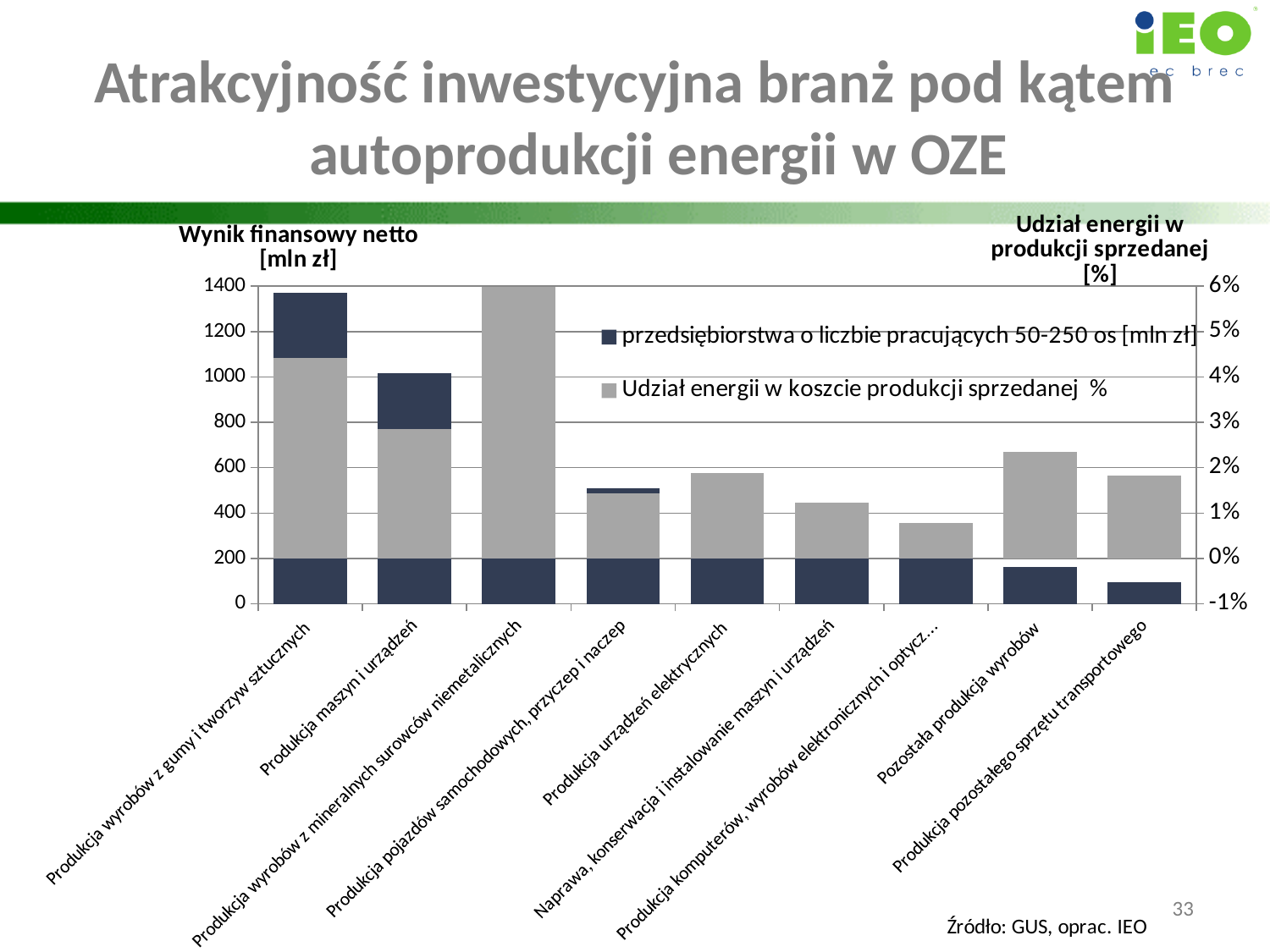
How many series does the chart legend list? 2 Is the value for 'Produkcja maszyn i urządzeń' in the series 'przedsiębiorstwa o liczbie pracujących 50-250 os [mln zł]' greater or less than 800? greater What is the title of the left vertical axis of the chart? Wynik finansowy netto [mln zł] Which category has the lowest value for the series 'przedsiębiorstwa o liczbie pracujących 50-250 os [mln zł]'? Produkcja pozostałego sprzętu transportowego Which category has the highest value for the series 'przedsiębiorstwa o liczbie pracujących 50-250 os [mln zł]'? Produkcja wyrobów z gumy i tworzyw sztucznych For the series 'przedsiębiorstwa o liczbie pracujących 50-250 os [mln zł]', which is larger: 'Produkcja wyrobów z gumy i tworzyw sztucznych' or 'Produkcja maszyn i urządzeń'? Produkcja wyrobów z gumy i tworzyw sztucznych Which category has the highest value for 'Udział energii w koszcie produkcji sprzedanej %'? Produkcja wyrobów z mineralnych surowców niemetalicznych Is the value for 'Pozostała produkcja wyrobów' in the series 'Udział energii w koszcie produkcji sprzedanej %' greater or less than 2%? greater What kind of chart is shown on the slide? bar chart How many industry categories are shown on the x axis of the chart? 9 Which category has the lowest value for 'Udział energii w koszcie produkcji sprzedanej %'? Produkcja komputerów, wyrobów elektronicznych i optycz… Is the value for 'Produkcja komputerów, wyrobów elektronicznych i optycz…' in the series 'Udział energii w koszcie produkcji sprzedanej %' greater or less than 1%? less